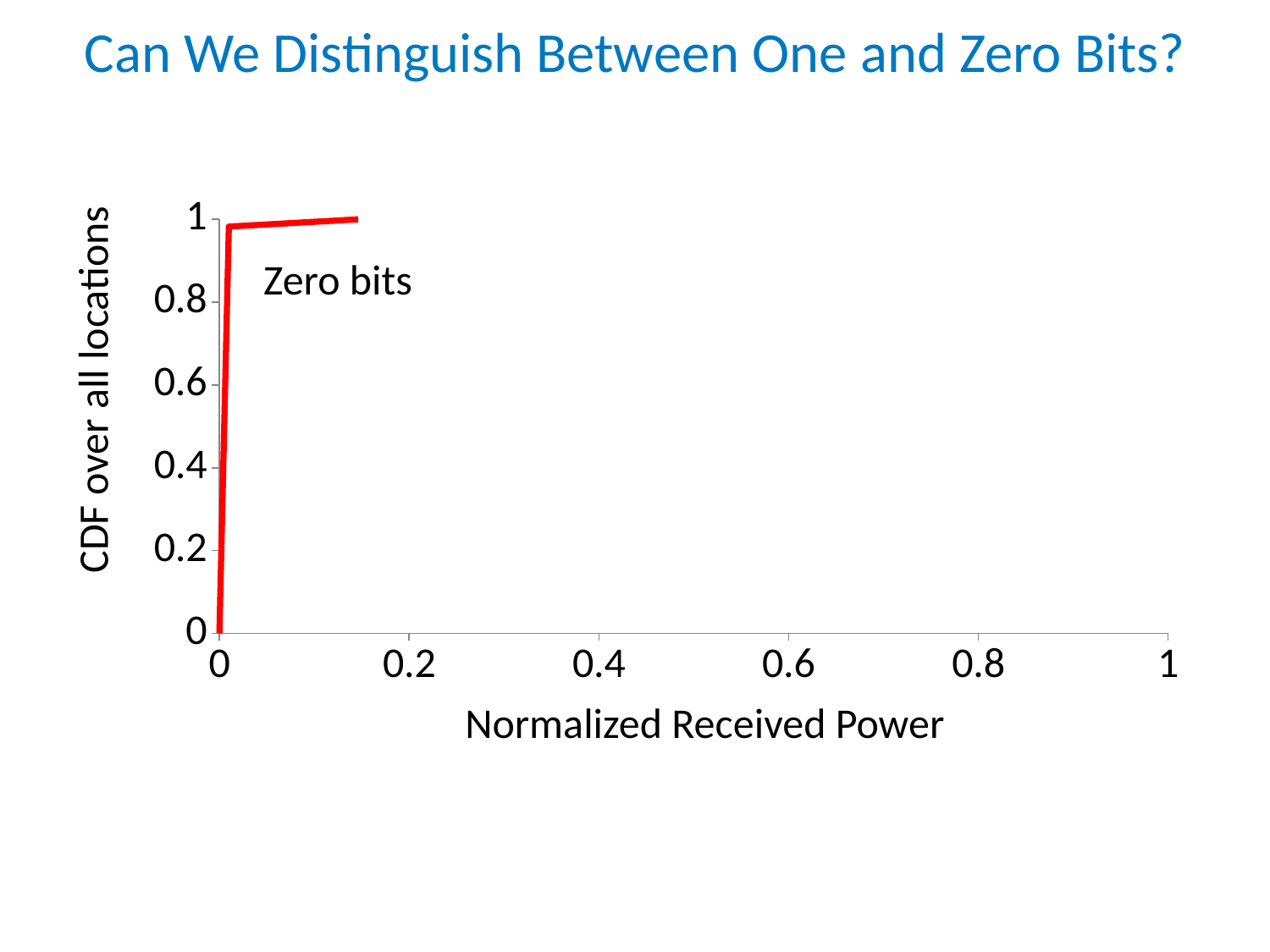
What is the label of the y axis? CDF over all locations What is the highest tick value shown on the x axis? 1 What kind of chart is shown on the slide? line chart Is the Normalized Received Power at which the Zero bits line reaches a CDF of 0.5 greater or less than 0.2? less Does the plotted line rise or fall as Normalized Received Power increases? rise Is the CDF value of the Zero bits line at a Normalized Received Power of 0.05 greater or less than 0.6? greater How many data series are plotted on the chart? 1 What is the label of the x axis? Normalized Received Power Is the CDF value of the Zero bits line at a Normalized Received Power of 0.1 greater or less than 0.8? greater